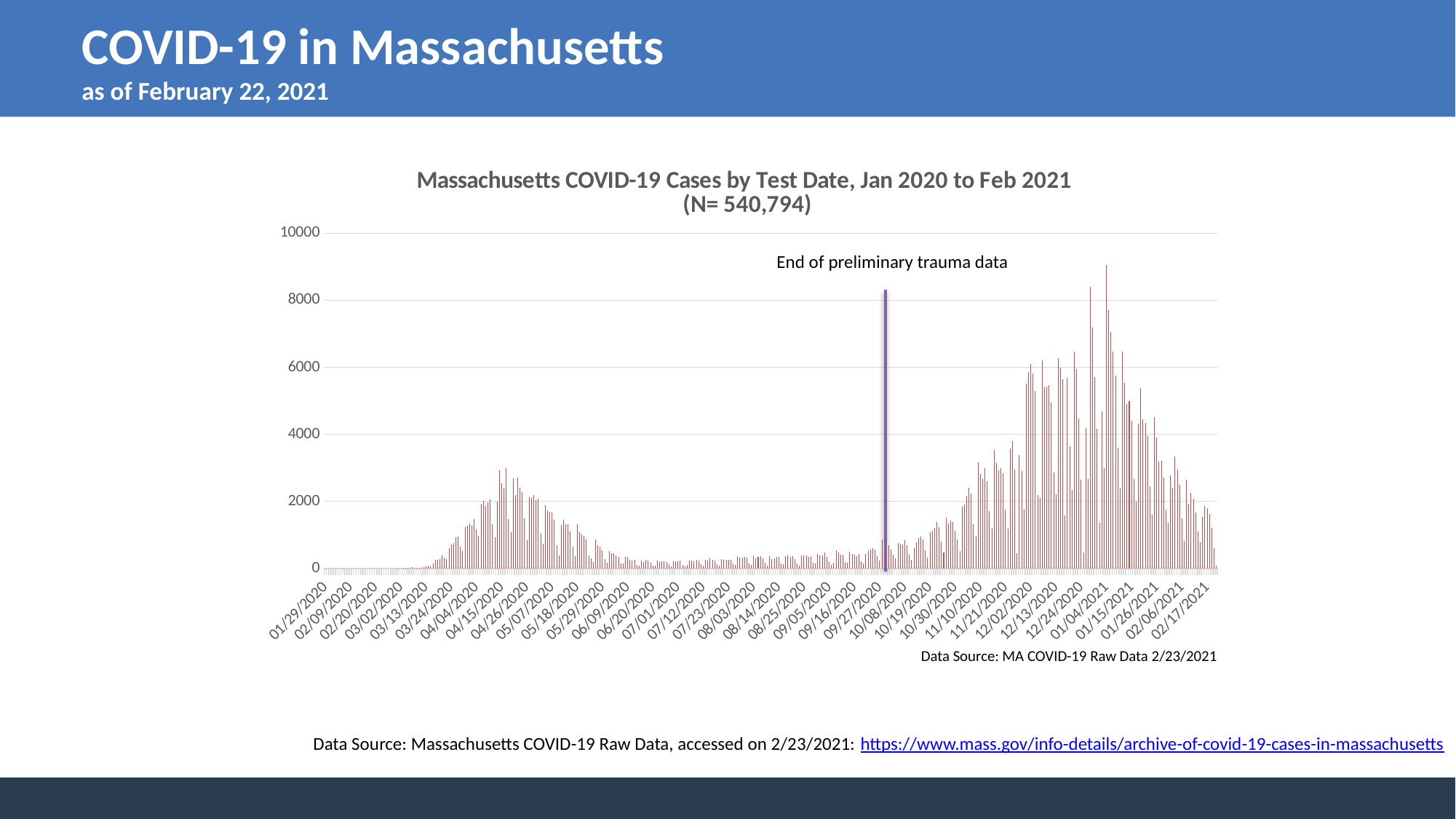
What is the highest value shown on the y-axis of the chart? 10000 What total N is stated in the chart title? 540,794 What is the title of the chart? Massachusetts COVID-19 Cases by Test Date, Jan 2020 to Feb 2021 (N= 540,794) Is the peak daily case value in the spring 2020 wave (around 04/15/2020) greater or less than 2000? greater Are the daily case values around 07/12/2020 greater or less than 2000? less Is the daily case value on 02/17/2021 greater or less than 4000? less What kind of chart is shown on the slide? Bar chart Do daily case values rise or fall between 04/26/2020 and 06/09/2020? Fall Which wave has the higher peak of daily cases: the spring 2020 wave (around April 2020) or the winter wave (around January 2021)? The winter wave (around January 2021) Do daily case values rise or fall between 10/19/2020 and 01/04/2021? Rise